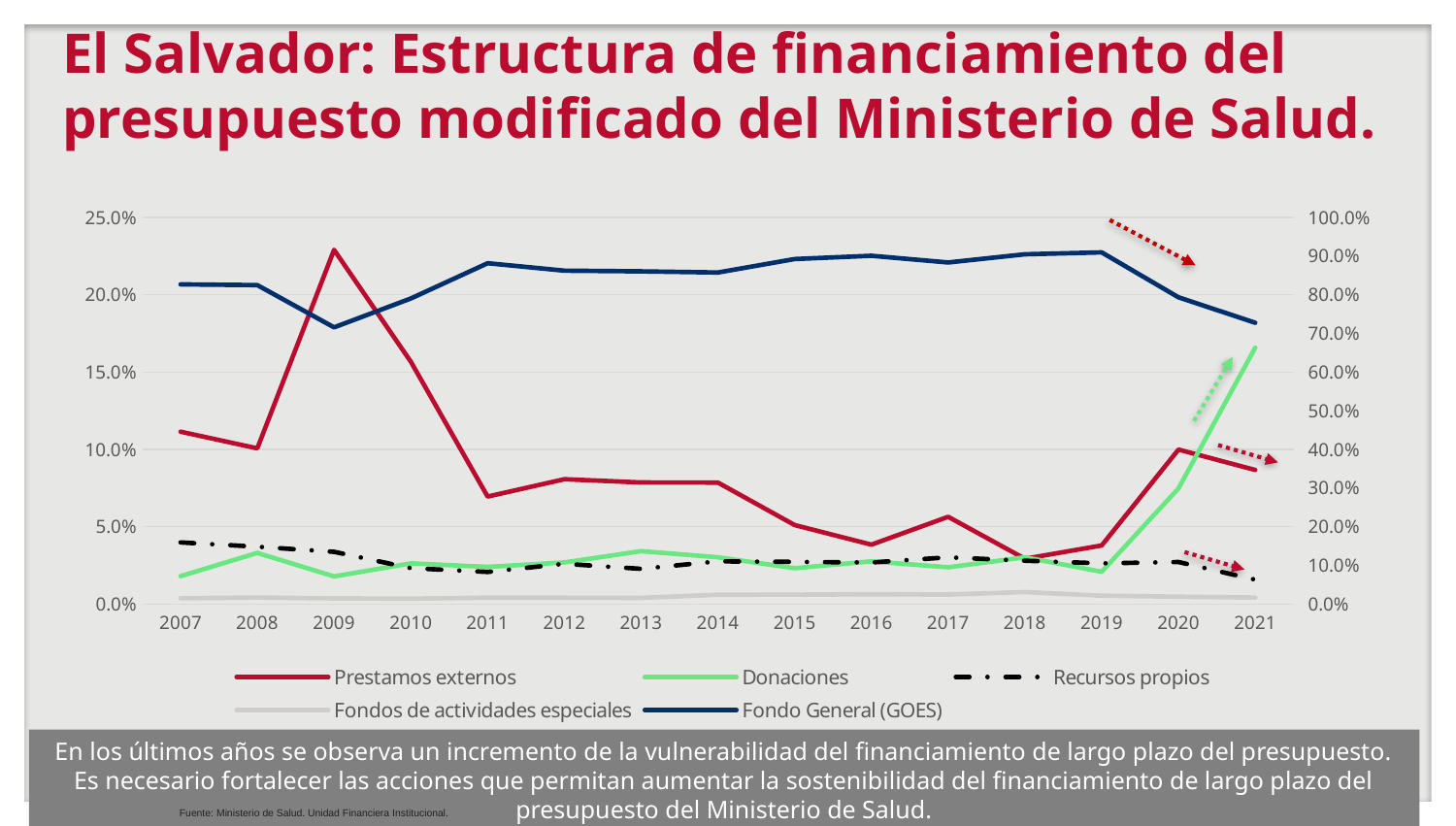
In which year does the Donaciones line reach its highest value? 2021 How many series does the legend list? 5 Is the value for Donaciones in 2021 greater or less than 15.0% on the left axis? greater Which series is drawn as a black dashed line? Recursos propios Does the Donaciones line rise or fall between 2019 and 2021? Rise Which is larger for Prestamos externos: the value in 2009 or the value in 2021? 2009 Is the value for Prestamos externos in 2011 greater or less than 10.0% on the left axis? less What kind of chart is shown on the slide? Line chart In which year does the Prestamos externos line reach its highest value? 2009 Does the Fondo General (GOES) line rise or fall between 2019 and 2021? Fall How many years are plotted along the x axis? 15 Is the value for Prestamos externos in 2009 greater or less than 20.0% on the left axis? greater